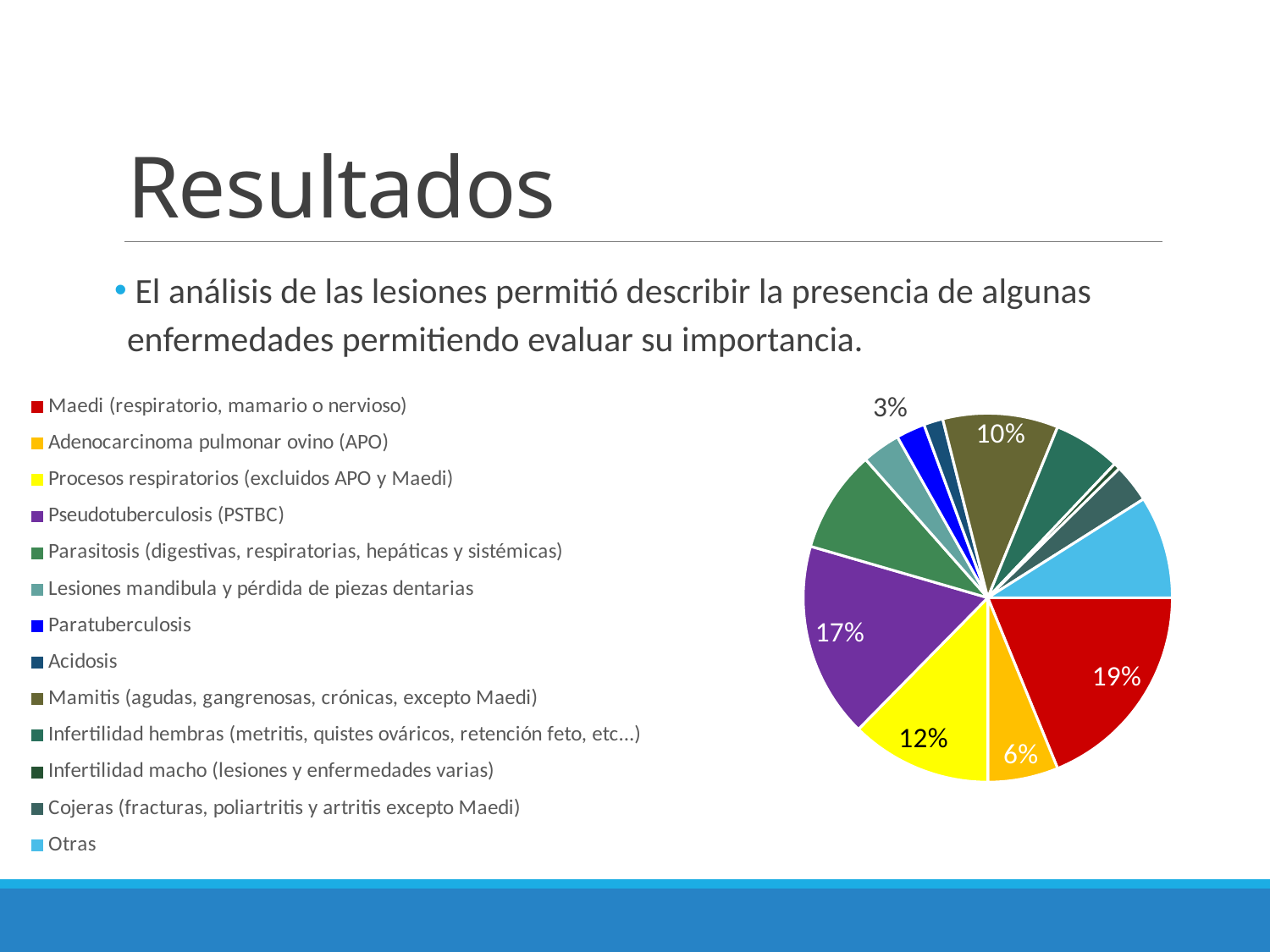
What is the difference in percentage points between Procesos respiratorios and Adenocarcinoma pulmonar ovino (APO)? 6 What percentage is shown for Mamitis (agudas, gangrenosas, crónicas, excepto Maedi)? 10% What share of the pie does Maedi (respiratorio, mamario o nervioso) represent? 19% What is the difference in percentage points between Maedi and Pseudotuberculosis (PSTBC)? 2 What percentage is shown for Pseudotuberculosis (PSTBC)? 17% What percentage is shown for Adenocarcinoma pulmonar ovino (APO)? 6% What colour is the slice for Maedi (respiratorio, mamario o nervioso)? red How many categories does the legend of the pie chart list? 13 What percentage is shown for Procesos respiratorios (excluidos APO y Maedi)? 12% What kind of chart is shown on the slide? pie chart Which is larger: the slice for Pseudotuberculosis (PSTBC) or the slice for Procesos respiratorios? Pseudotuberculosis (PSTBC) Which category has the largest slice of the pie? Maedi (respiratorio, mamario o nervioso)